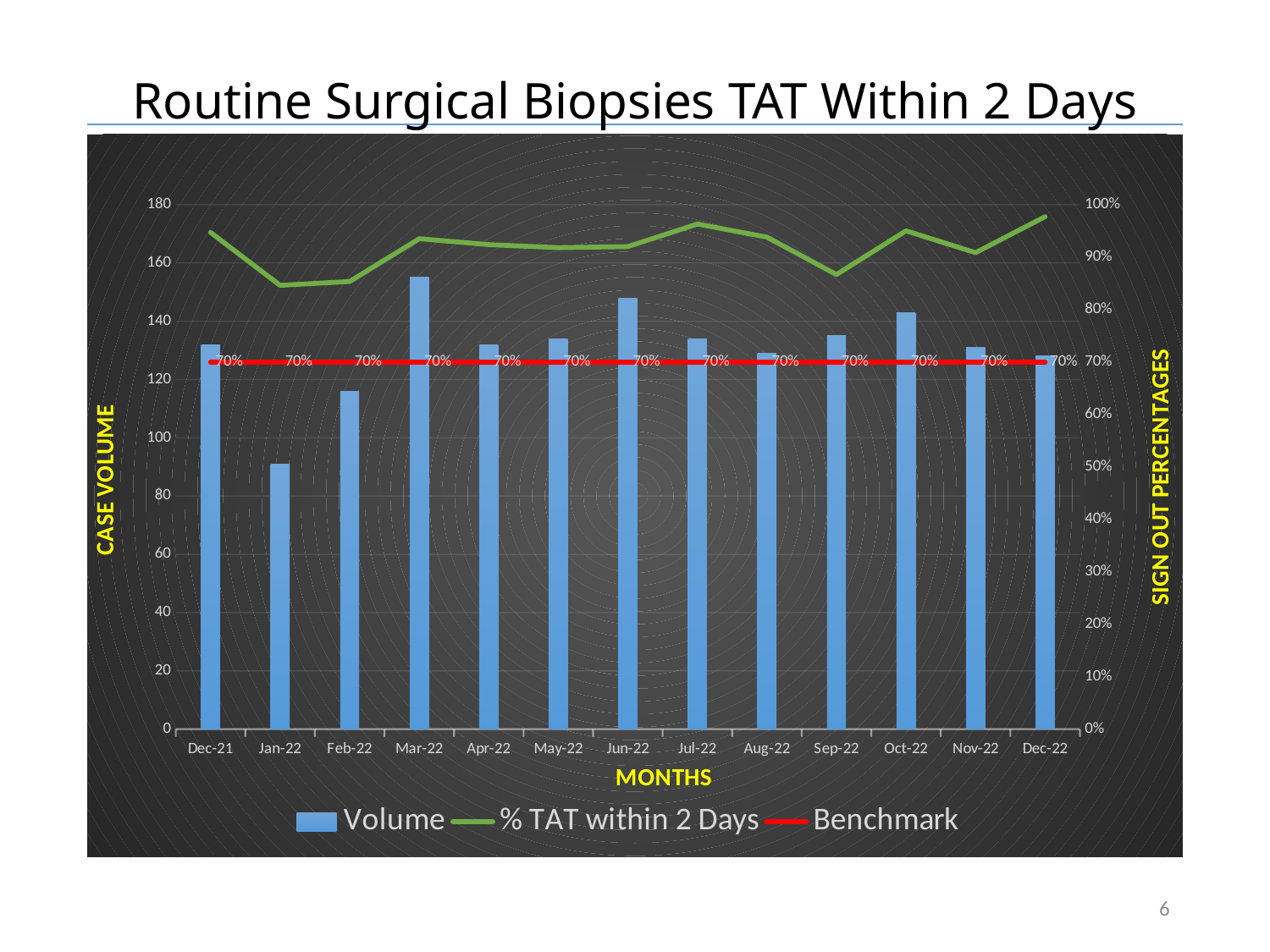
Which month has the highest % TAT within 2 Days value? Dec-22 Which month has the lowest case volume bar? Jan-22 Is the case volume for Jan-22 greater or less than 100? less What is the label of the right-hand vertical axis? SIGN OUT PERCENTAGES Is the % TAT within 2 Days for Dec-22 greater or less than 90%? greater Which month has a larger case volume, Jan-22 or Feb-22? Feb-22 How many months are shown on the x axis? 13 How many series does the legend list? 3 Is the % TAT within 2 Days for Jan-22 greater or less than 90%? less Which month has the highest case volume bar? Mar-22 What is the Benchmark value shown for Jun-22? 70%